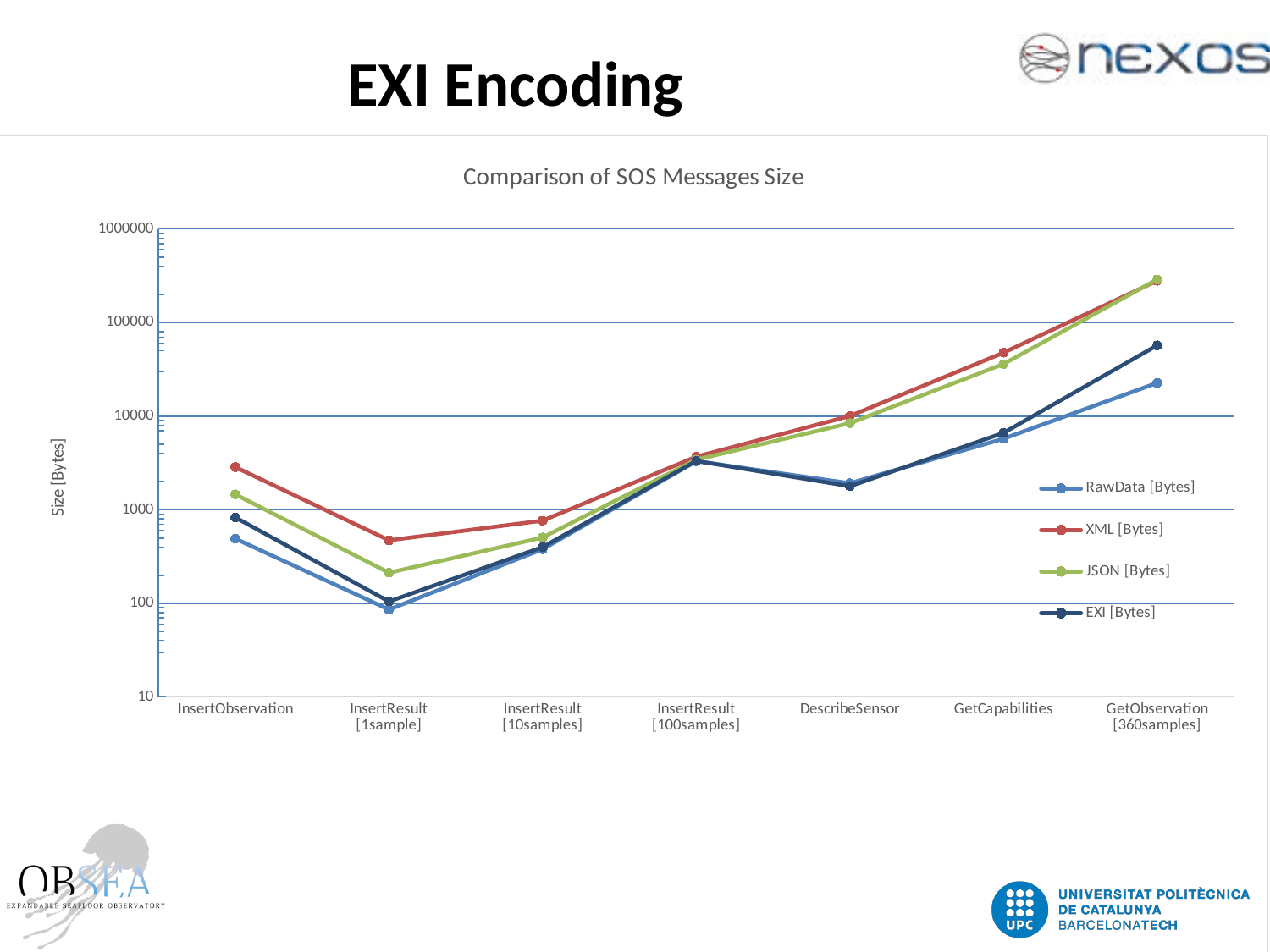
For which category is the XML [Bytes] series lowest? InsertResult [1sample] What is the title of the chart? Comparison of SOS Messages Size How many series does the legend list? 4 What is the label of the vertical axis? Size [Bytes] What kind of chart is shown on the slide? line chart For which category is the XML [Bytes] series highest? GetObservation [360samples] Which series has the lowest value for InsertObservation? RawData [Bytes] Which series has the highest value for InsertObservation? XML [Bytes] Is the value of XML [Bytes] for GetObservation [360samples] greater or less than 100000? greater Which is larger for GetObservation [360samples], EXI [Bytes] or RawData [Bytes]? EXI [Bytes] How many categories are shown on the x axis? 7